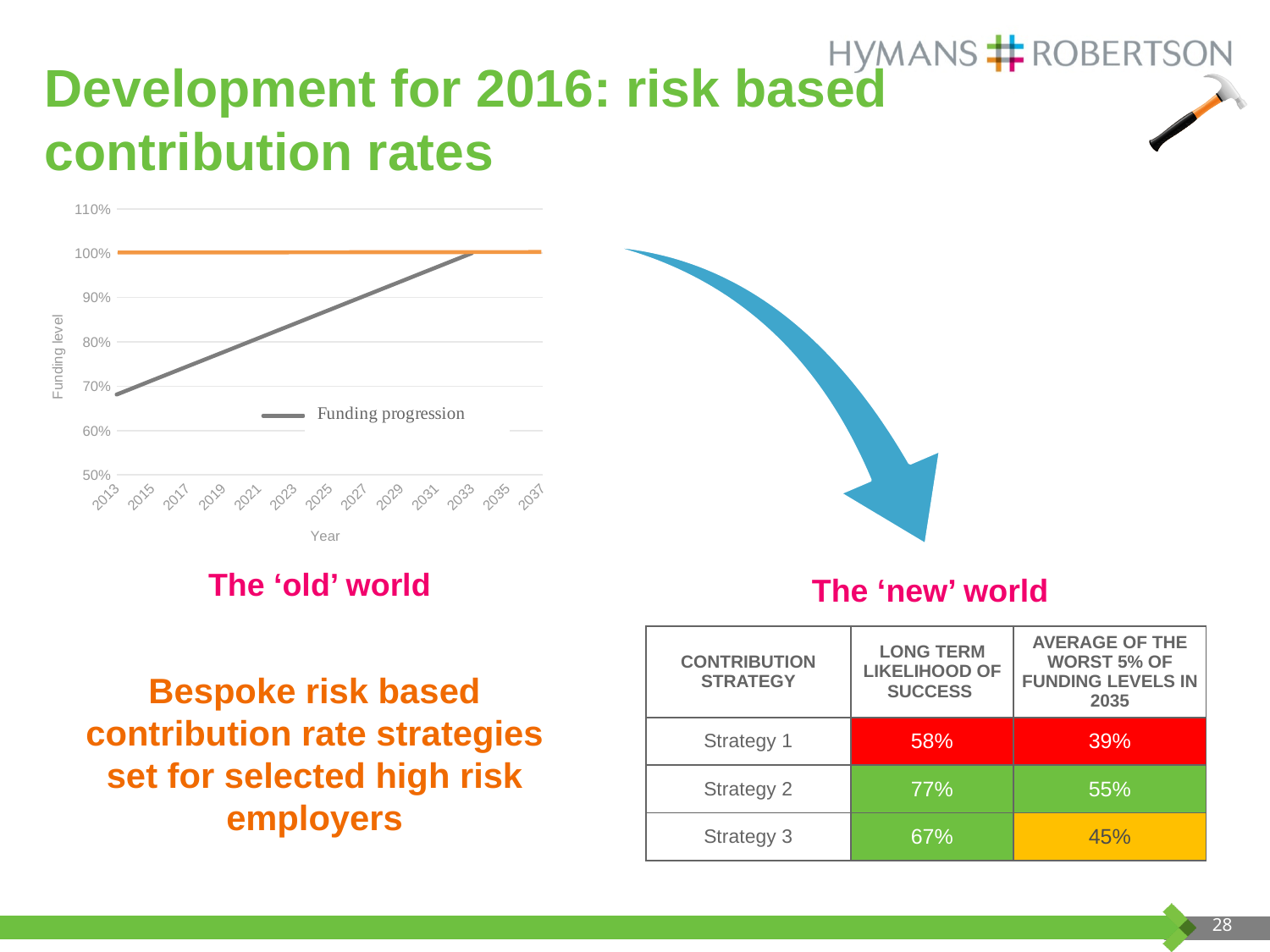
In which year does the Funding progression line reach the 100% level? 2033 How many year labels are shown on the x axis of the chart? 13 Is the Funding progression value in 2023 greater or less than 80%? greater What is the title of the chart's vertical axis? Funding level Is the Funding progression value in 2013 greater or less than 70%? less Is the Funding progression value in 2017 greater or less than 80%? less What kind of chart is shown on the slide? line chart Does the Funding progression line rise or fall from 2013 to 2033? rise What is the name of the series shown in the chart legend? Funding progression How many series does the chart legend list? 1